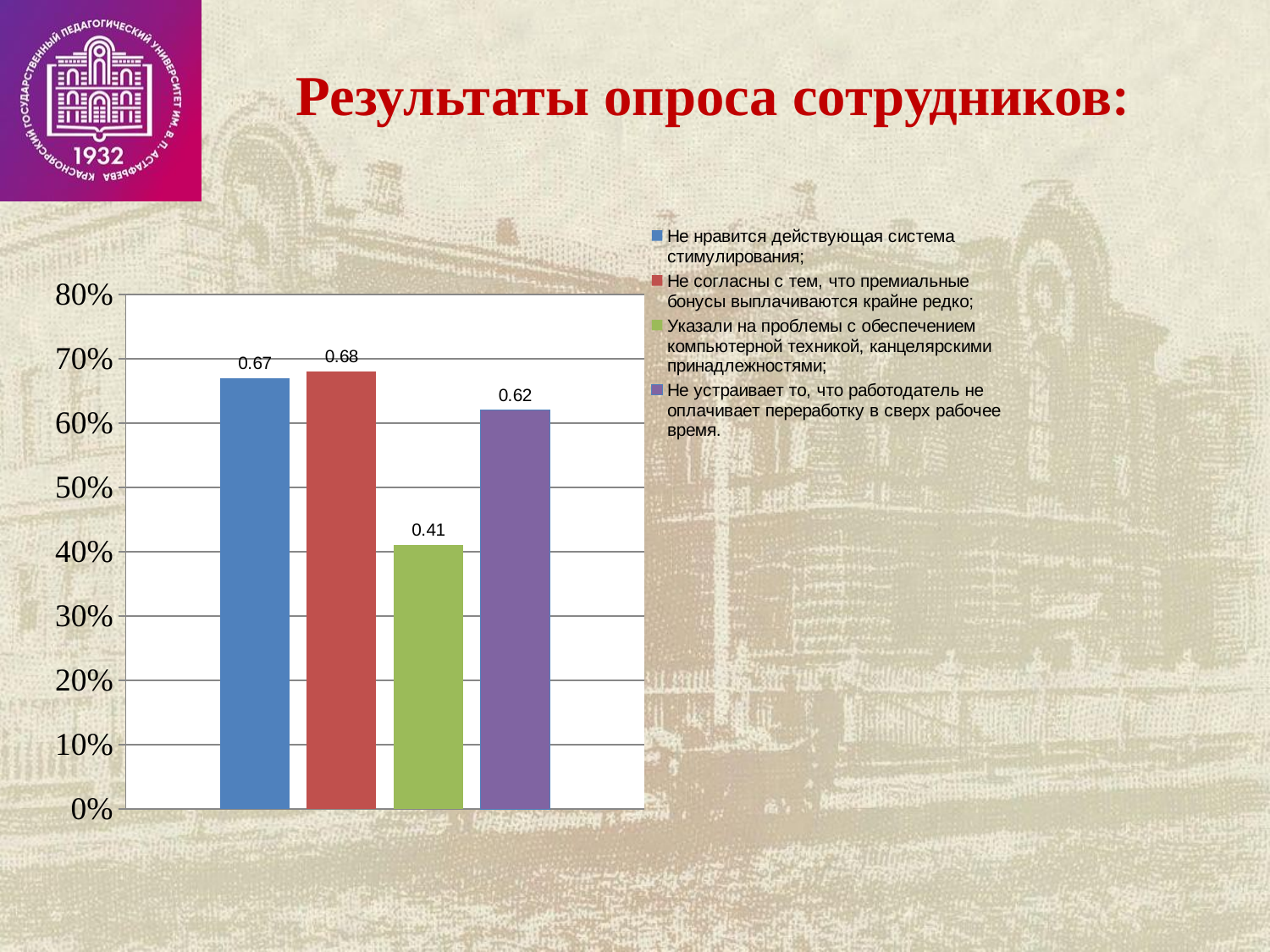
Which series has the highest value? Не согласны с тем, что премиальные бонусы выплачиваются крайне редко What is the difference between the value for "Не нравится действующая система стимулирования" and the value for "Указали на проблемы с обеспечением компьютерной техникой, канцелярскими принадлежностями"? 0.26 What is the value shown for the series "Не согласны с тем, что премиальные бонусы выплачиваются крайне редко"? 0.68 How many series does the legend list? 4 What is the value shown for the series "Не нравится действующая система стимулирования"? 0.67 Which series has the lowest value? Указали на проблемы с обеспечением компьютерной техникой, канцелярскими принадлежностями What is the value shown for the series "Не устраивает то, что работодатель не оплачивает переработку в сверх рабочее время"? 0.62 What is the title of the slide containing the chart? Результаты опроса сотрудников: Is the value for "Не устраивает то, что работодатель не оплачивает переработку в сверх рабочее время" greater or less than 50%? greater What type of chart is shown on the slide? bar chart What is the value shown for the series "Указали на проблемы с обеспечением компьютерной техникой, канцелярскими принадлежностями"? 0.41 Which is larger: the value for "Не устраивает то, что работодатель не оплачивает переработку в сверх рабочее время" or the value for "Указали на проблемы с обеспечением компьютерной техникой, канцелярскими принадлежностями"? Не устраивает то, что работодатель не оплачивает переработку в сверх рабочее время